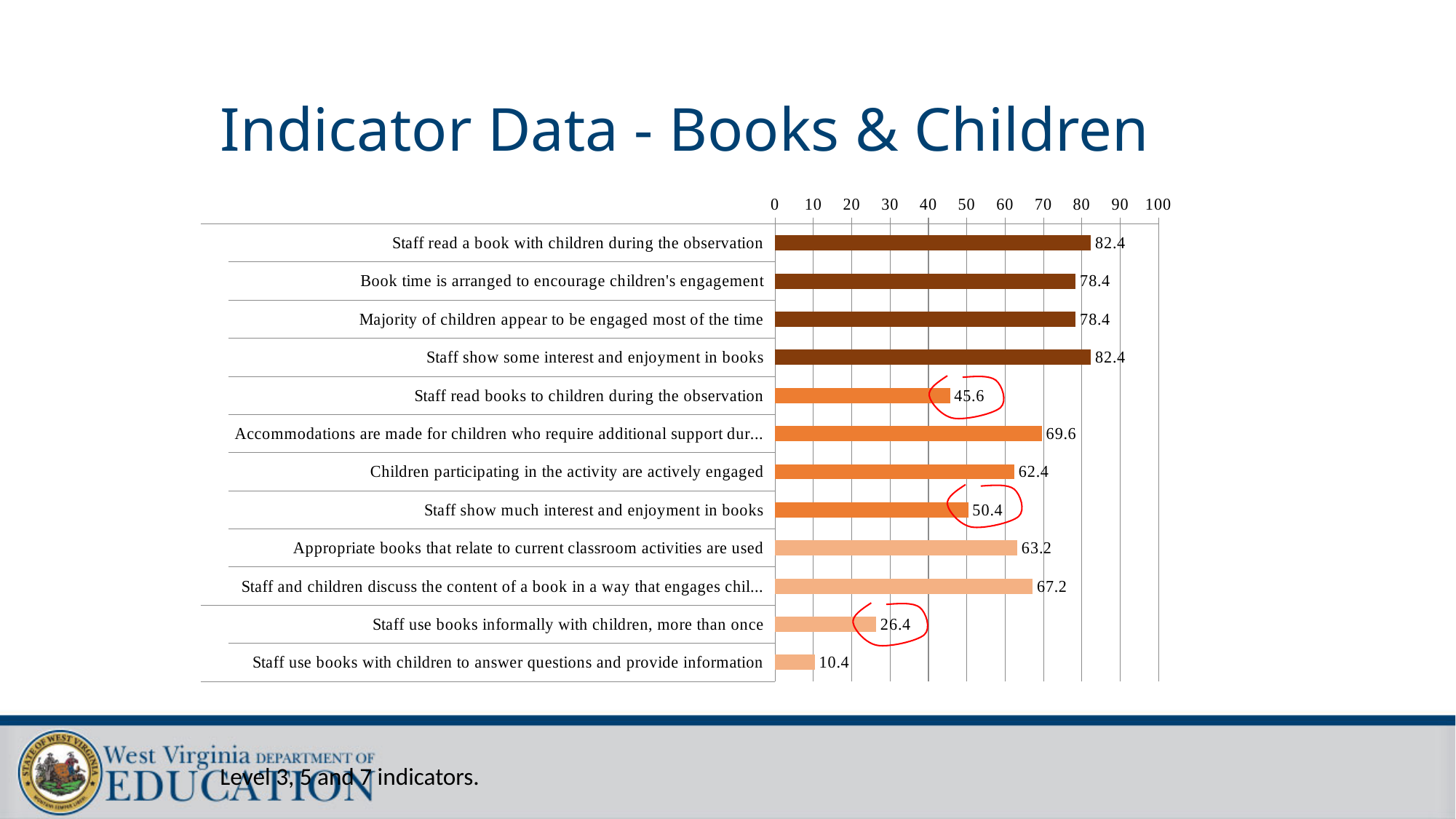
What kind of chart is shown on the slide? bar chart What is the difference between the values for "Accommodations are made for children who require additional support dur..." and "Children participating in the activity are actively engaged"? 7.2 What is the value for "Staff read a book with children during the observation"? 82.4 What is the title of the slide containing the chart? Indicator Data - Books & Children What is the value for "Staff use books with children to answer questions and provide information"? 10.4 What is the value for "Appropriate books that relate to current classroom activities are used"? 63.2 What is the difference between the values for "Staff show some interest and enjoyment in books" and "Staff show much interest and enjoyment in books"? 32 What is the value for "Staff read books to children during the observation"? 45.6 Which is larger: the value for "Staff show much interest and enjoyment in books" or the value for "Staff use books informally with children, more than once"? Staff show much interest and enjoyment in books How many categories are shown in the chart? 12 Which category has the lowest value? Staff use books with children to answer questions and provide information Is the value for "Staff and children discuss the content of a book in a way that engages chil..." greater or less than 60? greater